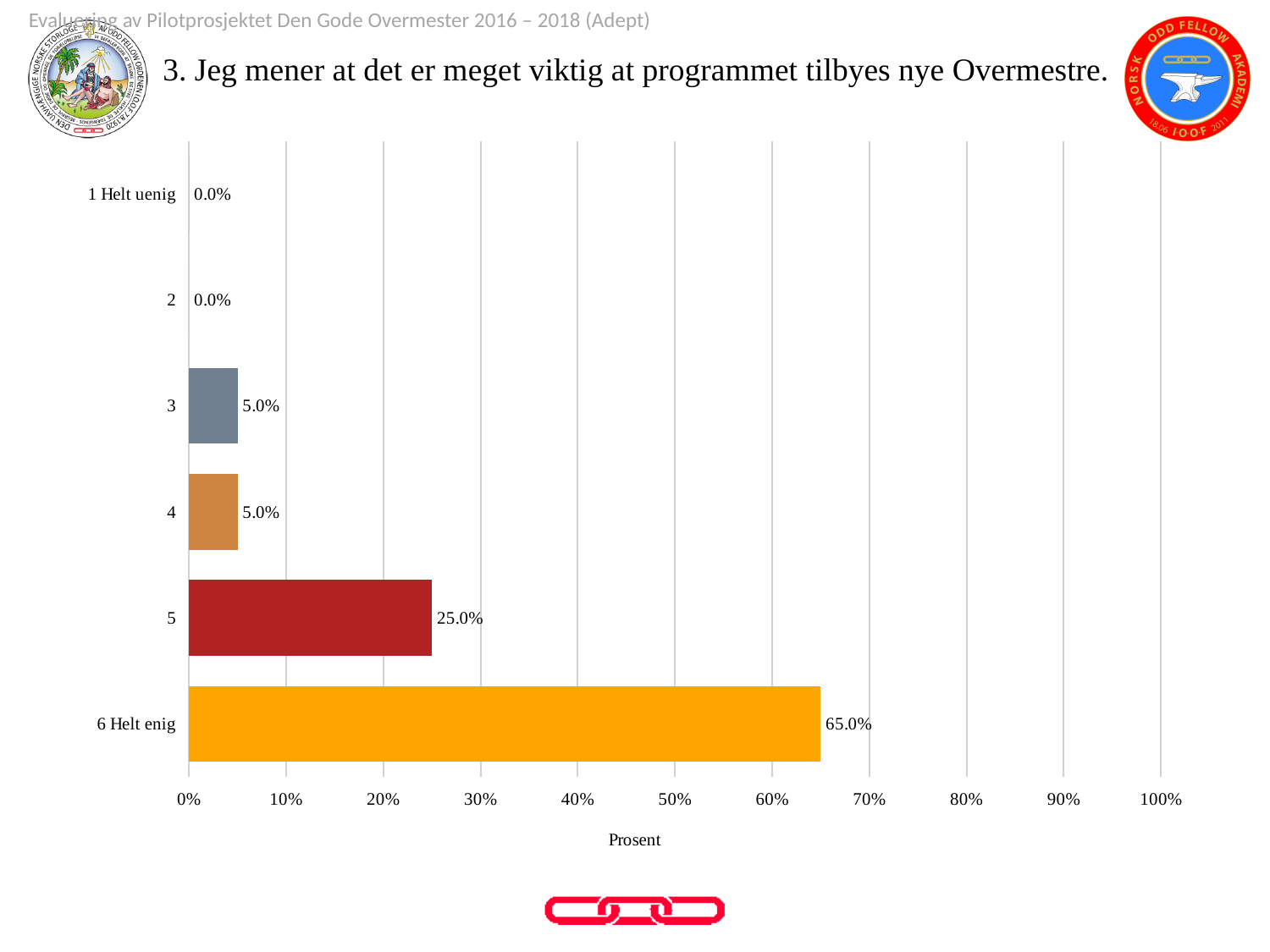
How many categories are shown on the chart? 6 Is the value for "6 Helt enig" greater or less than 60%? greater What is the value for "6 Helt enig"? 65.0% What is the value for "1 Helt uenig"? 0.0% What kind of chart is shown on the slide? bar chart What is the difference between the values for "6 Helt enig" and category 5? 40.0% Which is larger, the value for category 5 or the value for category 4? 5 What is the difference between the values for category 5 and category 4? 20.0% What is the label of the horizontal axis? Prosent Which category has the highest value? 6 Helt enig What is the value for category 5? 25.0% What is the value for category 3? 5.0%